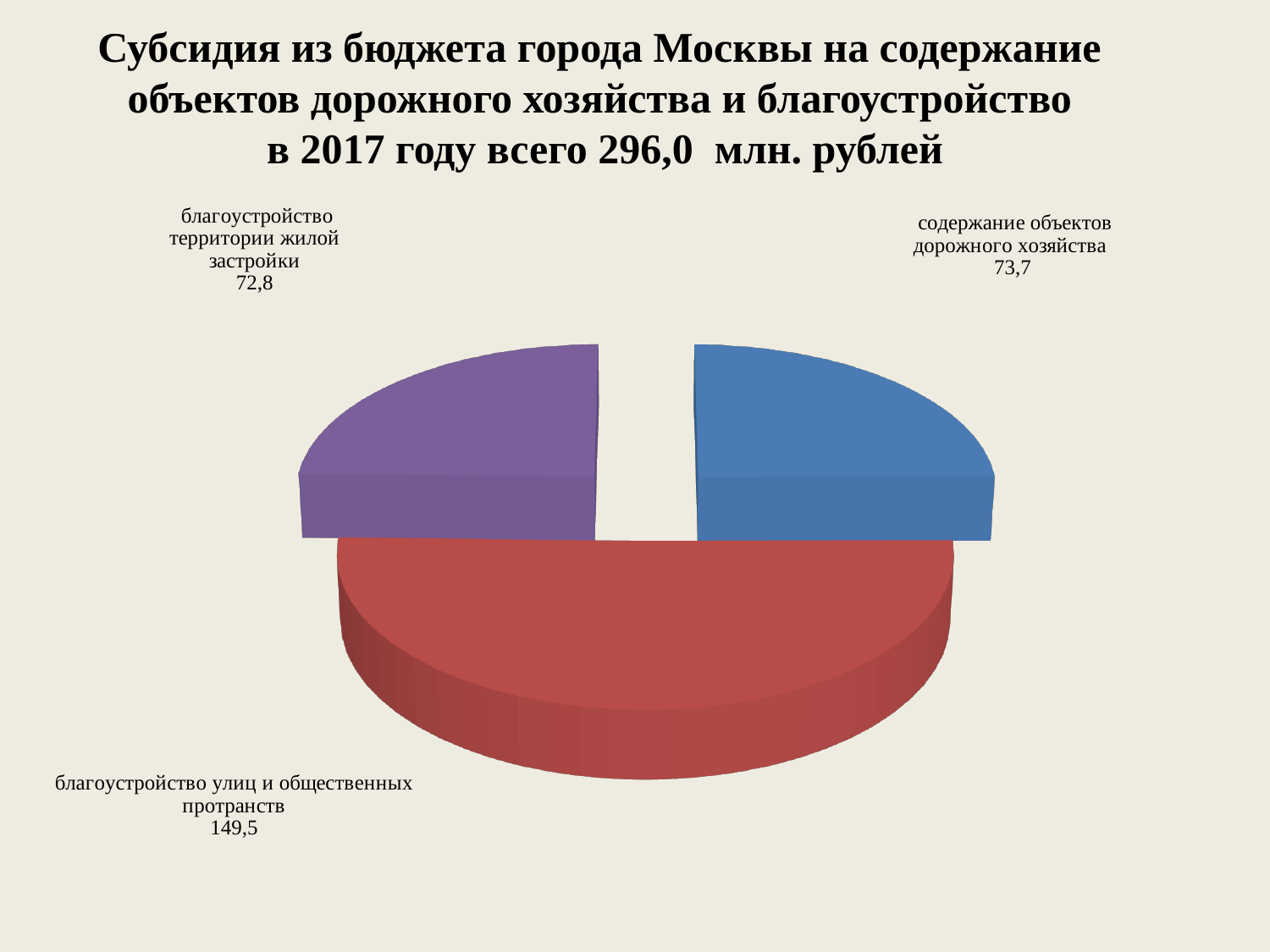
What colour is the slice for содержание объектов дорожного хозяйства? blue Which category has the smallest value? благоустройство территории жилой застройки What is the value for благоустройство территории жилой застройки? 72,8 What is the value for благоустройство улиц и общественных протранств? 149,5 What is the difference between благоустройство улиц и общественных протранств and содержание объектов дорожного хозяйства? 75,8 What type of chart is shown on the slide? pie chart Which is larger: содержание объектов дорожного хозяйства or благоустройство территории жилой застройки? содержание объектов дорожного хозяйства How many slices does the pie chart have? 3 What is the value for содержание объектов дорожного хозяйства? 73,7 What share of the pie does благоустройство улиц и общественных протранств represent? 50,5% What is the difference between содержание объектов дорожного хозяйства and благоустройство территории жилой застройки? 0,9 Which category has the largest value? благоустройство улиц и общественных протранств